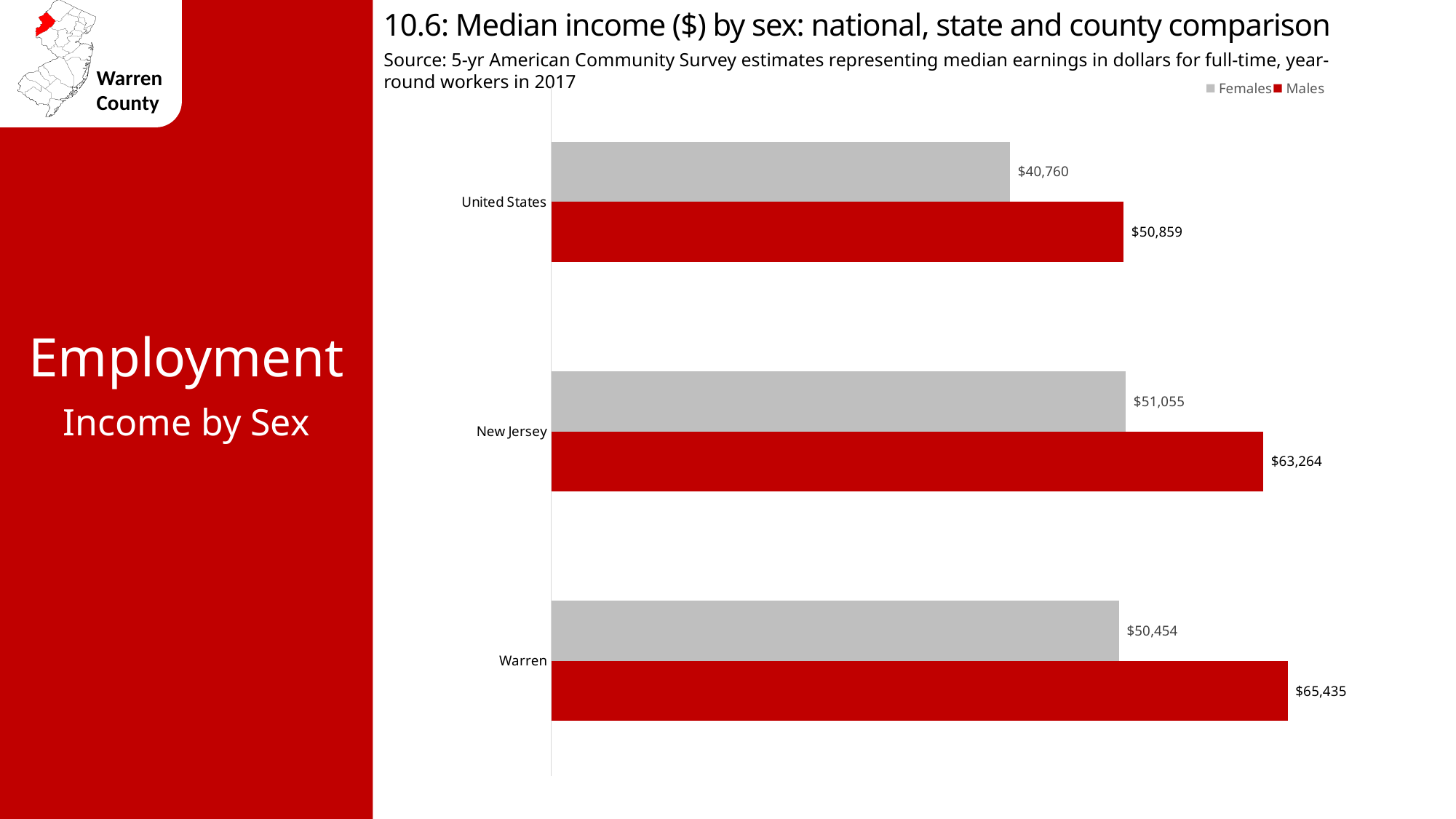
What is the median income for Females in the United States? $40,760 Which is larger: the Females median income in New Jersey or in Warren? New Jersey What kind of chart is shown on the slide? Bar chart What is the difference between the Males median income in New Jersey and in the United States? $12,405 What is the difference between the Males and Females median income in Warren? $14,981 What is the median income for Males in Warren? $65,435 Which geography has the highest median income for Males? Warren How many series does the legend list? 2 How many geographies are shown on the chart? 3 What is the median income for Males in the United States? $50,859 What is the median income for Females in New Jersey? $51,055 Which geography has the lowest median income for Females? United States